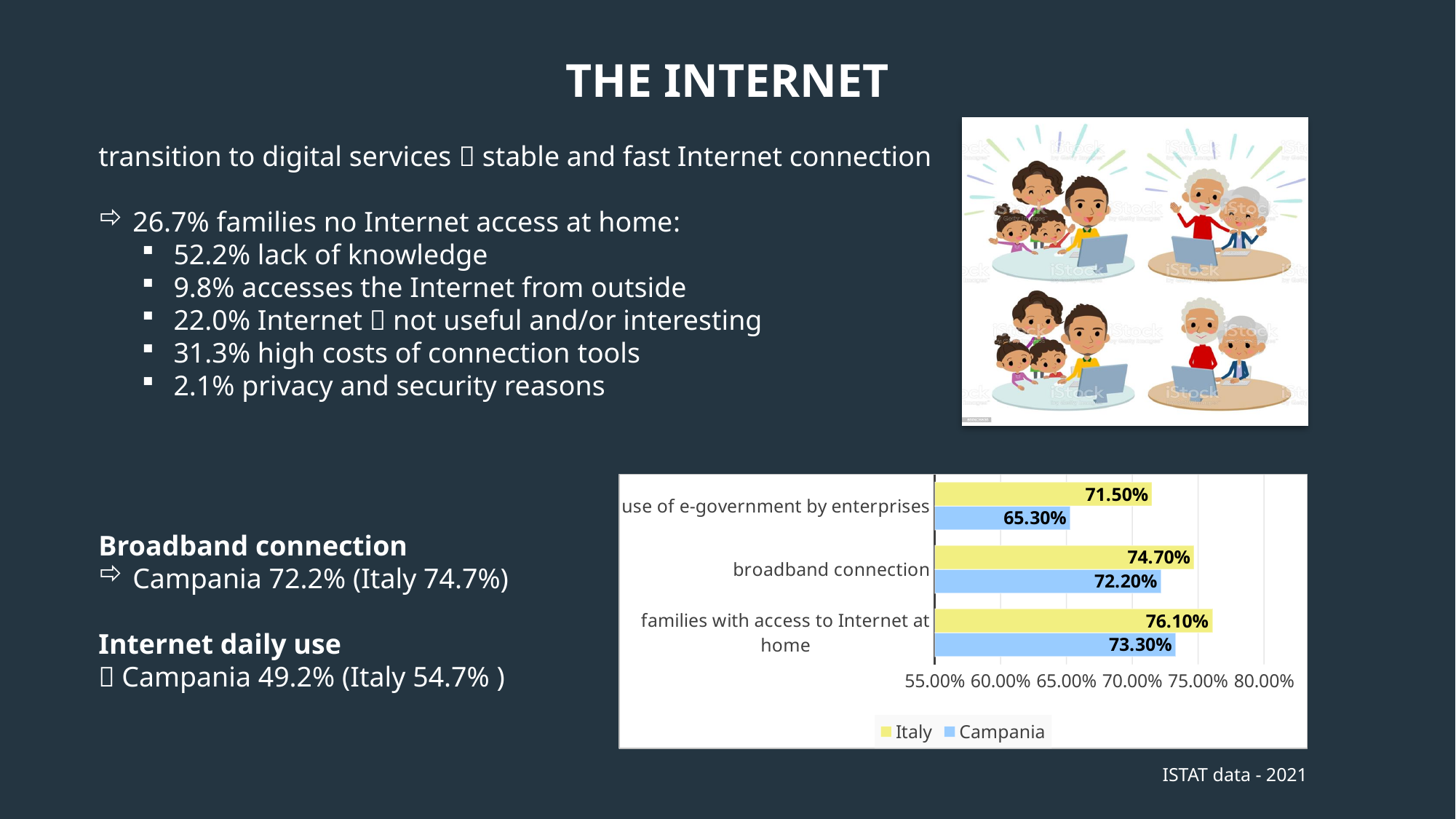
Which is larger for families with access to Internet at home, the Italy value or the Campania value? Italy What kind of chart is shown on the slide? bar chart What is the Italy value for broadband connection? 74.70% What is the Campania value for use of e-government by enterprises? 65.30% Which category has the lowest Campania value? use of e-government by enterprises Which category has the highest Italy value? families with access to Internet at home What is the difference between the Italy and Campania values for broadband connection? 2.50 percentage points What is the difference between the Italy and Campania values for use of e-government by enterprises? 6.20 percentage points What is the Italy value for use of e-government by enterprises? 71.50% How many categories are shown in the chart? 3 How many series does the chart legend list? 2 What is the Campania value for families with access to Internet at home? 73.30%